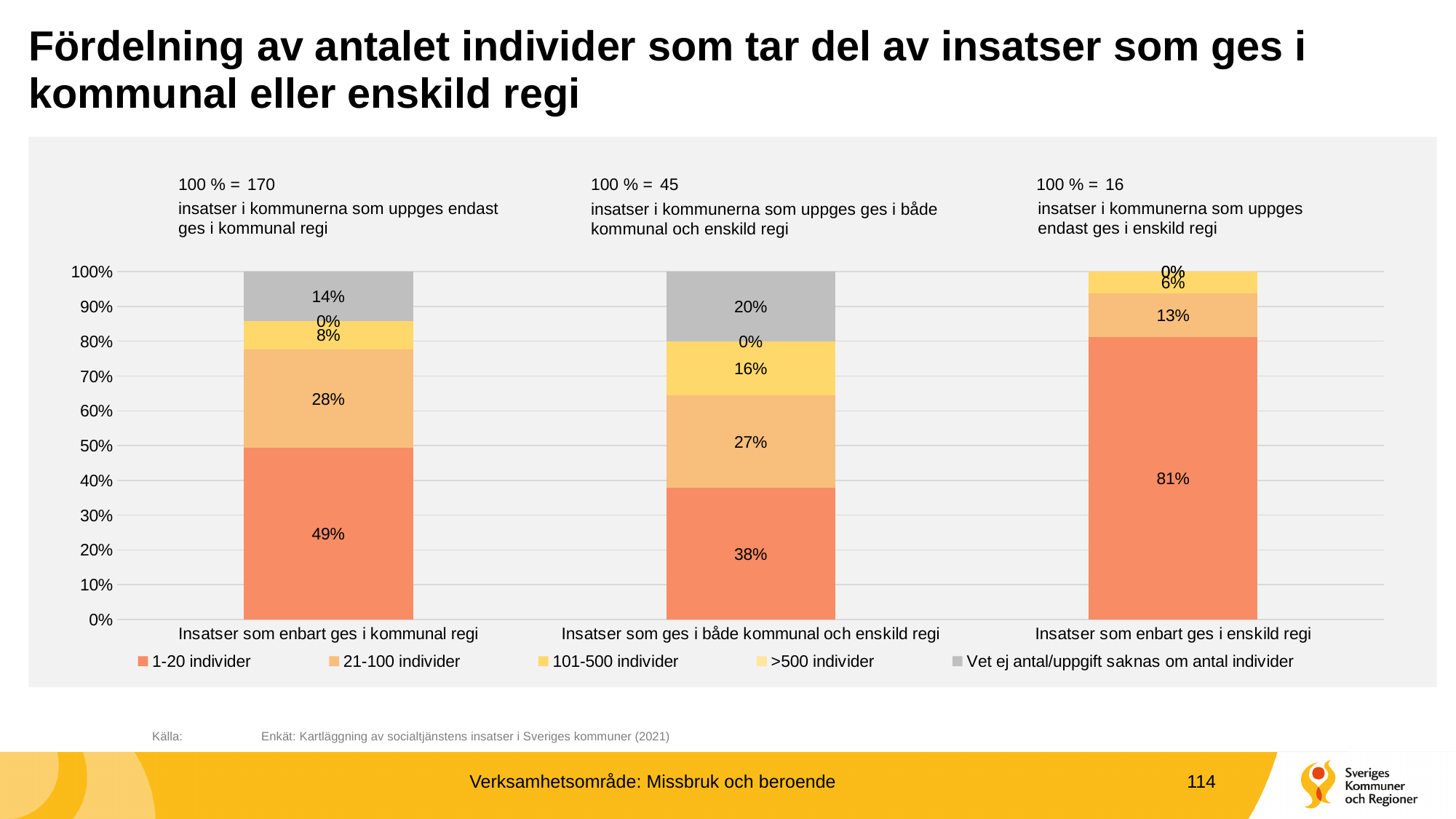
Which category has the lowest share of '1-20 individer'? Insatser som ges i både kommunal och enskild regi What is the share of '1-20 individer' for 'Insatser som enbart ges i enskild regi'? 81% What is the share of '1-20 individer' for 'Insatser som enbart ges i kommunal regi'? 49% Which category has the highest share of '1-20 individer'? Insatser som enbart ges i enskild regi What is the share of 'Vet ej antal/uppgift saknas om antal individer' for 'Insatser som ges i både kommunal och enskild regi'? 20% How many categories are shown on the x axis of the chart? 3 How many series does the legend list? 5 Which is larger: the '101-500 individer' share for 'Insatser som enbart ges i kommunal regi' or for 'Insatser som ges i både kommunal och enskild regi'? Insatser som ges i både kommunal och enskild regi What is the share of '21-100 individer' for 'Insatser som enbart ges i enskild regi'? 13% What is the difference in percentage points between the '1-20 individer' share for 'Insatser som enbart ges i kommunal regi' and for 'Insatser som ges i både kommunal och enskild regi'? 11 percentage points According to the note above the first bar, how many insatser does 100 % correspond to for 'Insatser som enbart ges i kommunal regi'? 170 What kind of chart is shown on the slide? Stacked bar chart